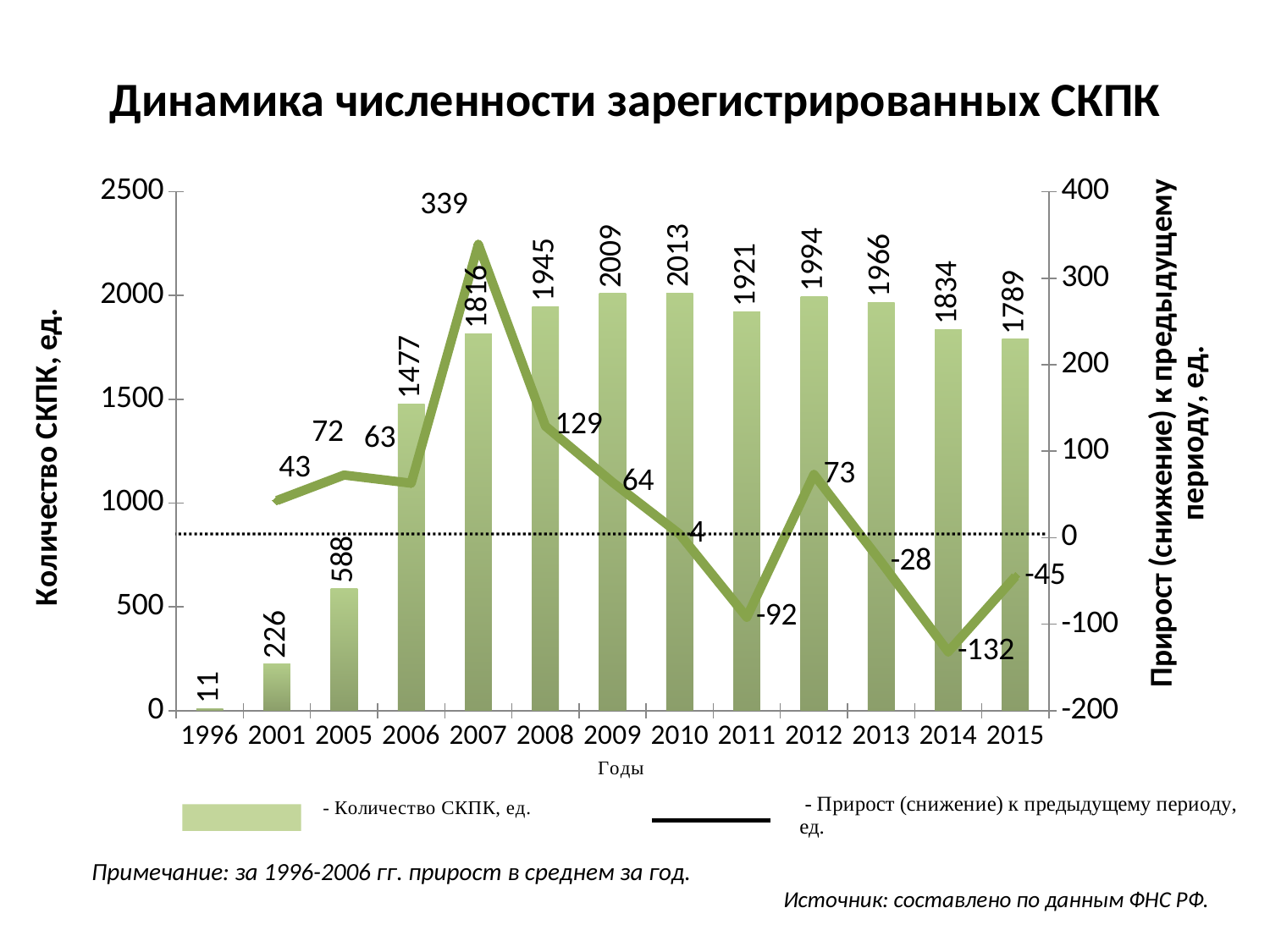
In which year is the number of SCPCs (bar series) lowest? 1996 Which year has a larger number of SCPCs, 2006 or 2008? 2008 In which year does the growth line (Прирост) reach its highest value? 2007 What is the number of registered SCPCs (Количество СКПК) shown for 2007? 1816 How many series does the legend list? 2 How many years are shown on the x axis? 13 What is the value of the growth line (Прирост) for 2014? -132 What is the title of the chart? Динамика численности зарегистрированных СКПК What is the difference between the number of SCPCs in 2010 and in 2015? 224 What kind of chart is used for the number of SCPCs series? Bar chart Does the number of SCPCs rise or fall from 2010 to 2015? Fall In which year is the number of SCPCs (bar series) highest? 2010